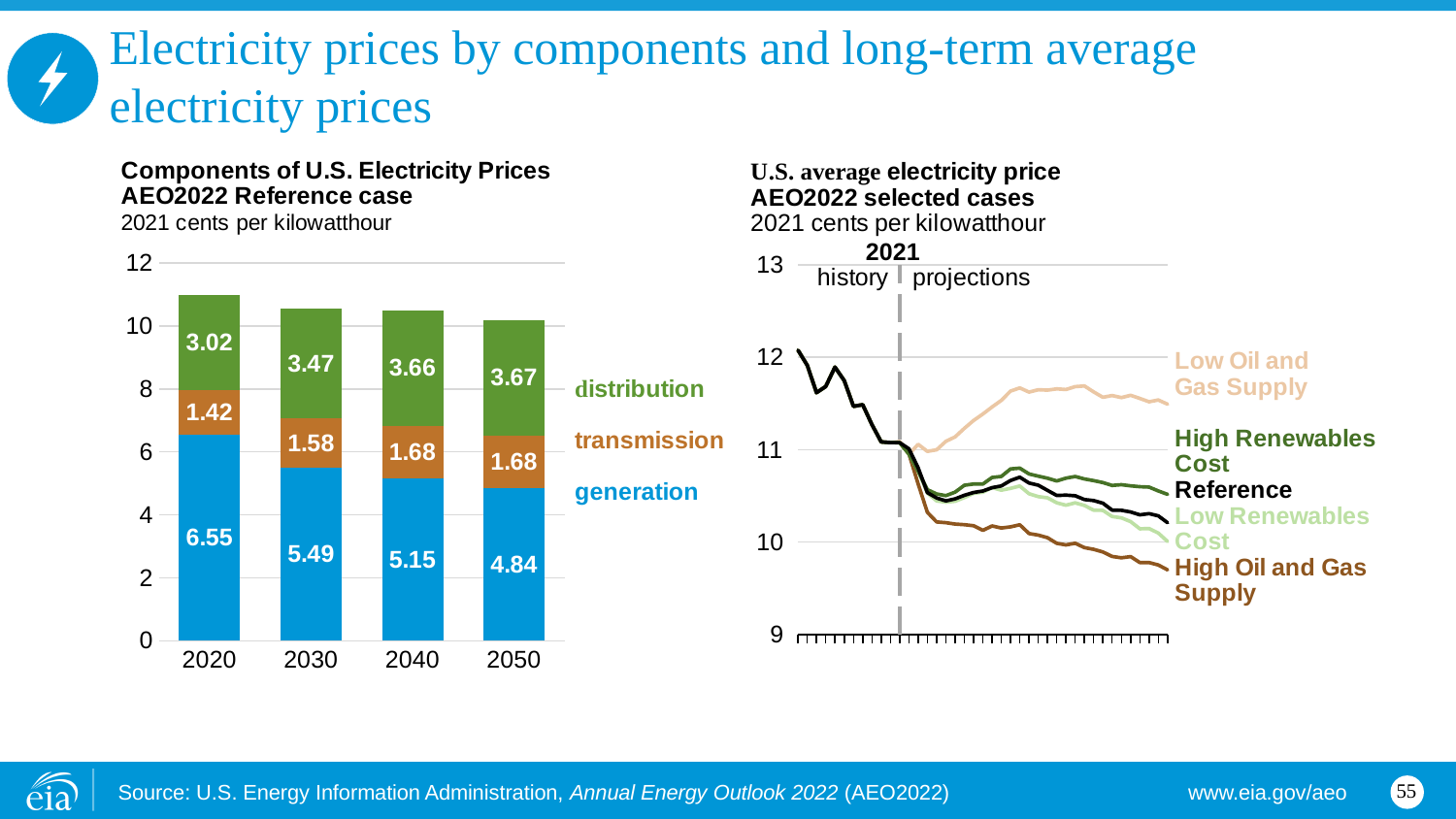
In the Components of U.S. Electricity Prices chart, what is the generation value for 2020? 6.55 How many cases does the U.S. average electricity price chart show? 5 In the Components of U.S. Electricity Prices chart, does the generation value rise or fall from 2020 to 2050? fall What kind of chart is the U.S. average electricity price chart? line chart In the Components of U.S. Electricity Prices chart, which is larger for 2030: distribution or transmission? distribution In the Components of U.S. Electricity Prices chart, what is the difference between the generation values for 2020 and 2050? 1.71 In the U.S. average electricity price chart, is the value for High Oil and Gas Supply at the end of the projection greater or less than 10? less In the Components of U.S. Electricity Prices chart, what is the distribution value for 2050? 3.67 In the Components of U.S. Electricity Prices chart, what is the transmission value for 2030? 1.58 In the Components of U.S. Electricity Prices chart, which year has the lowest generation value? 2050 In the Components of U.S. Electricity Prices chart, what is the total of the stacked bar for 2020? 10.99 In the Components of U.S. Electricity Prices chart, which year has the highest generation value? 2020